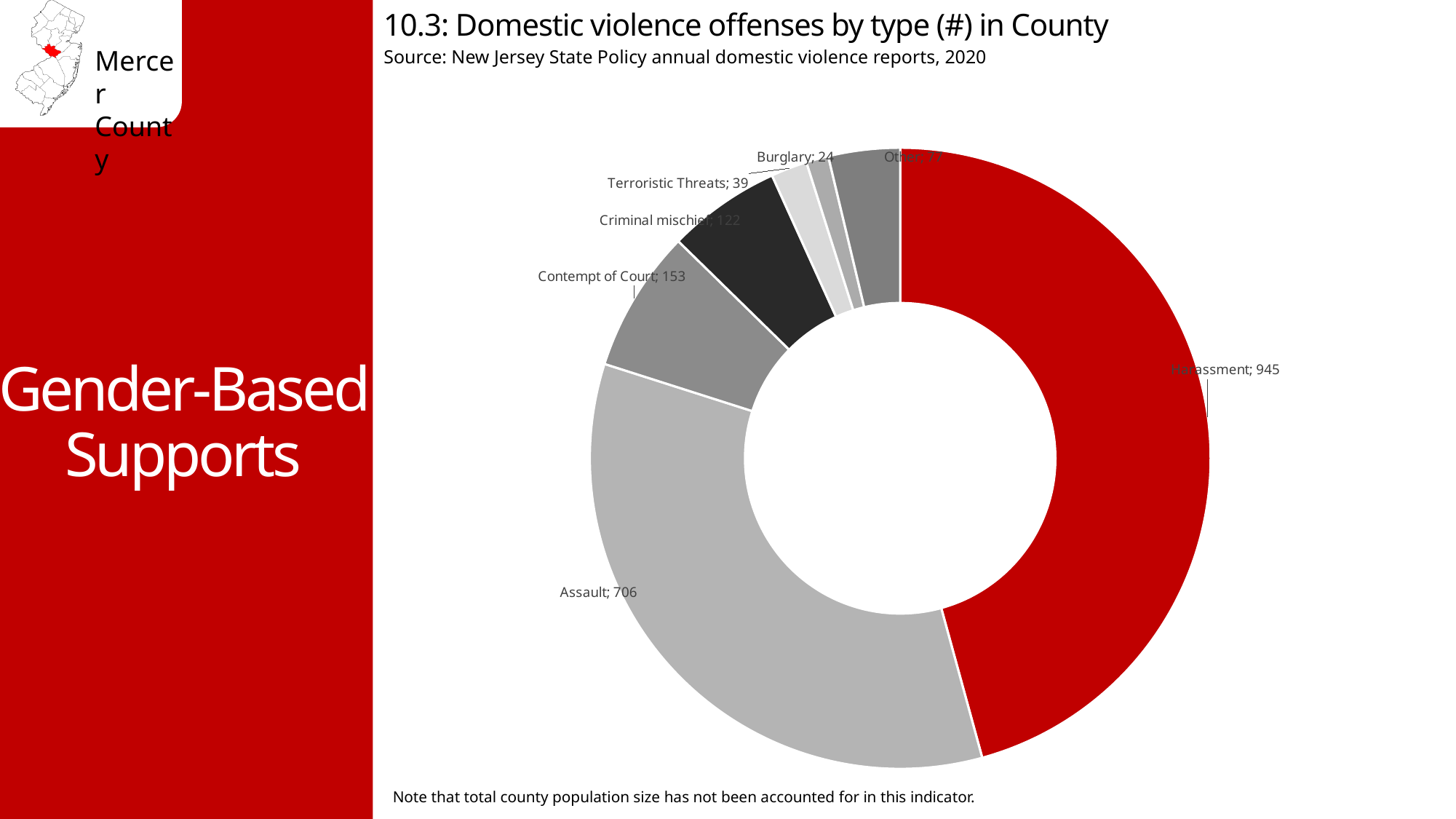
What is the value for Terroristic Threats? 39 What is the value for Burglary? 24 Which offense type has the highest number of domestic violence offenses? Harassment Which is larger, the value for Assault or the value for Contempt of Court? Assault What is the value for Criminal mischief? 122 What is the difference between the values for Contempt of Court and Criminal mischief? 31 What is the difference between the values for Harassment and Assault? 239 What is the value for Harassment? 945 What is the value for Contempt of Court? 153 What year of data does the chart's source line cite? 2020 What kind of chart is shown on the slide? Doughnut chart What is the value for Assault? 706